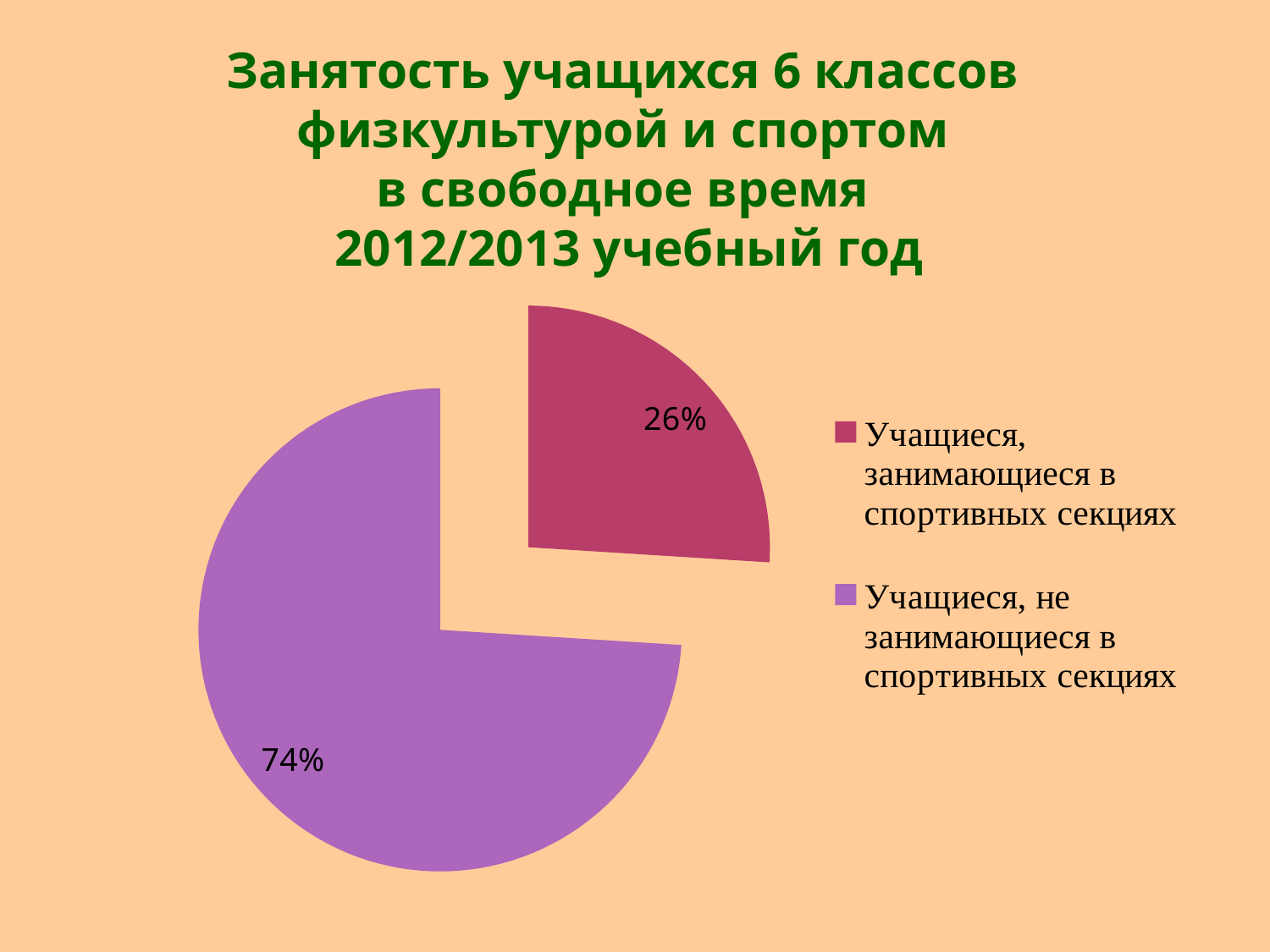
What kind of chart is shown on the slide? pie chart Which category has the smallest slice of the pie? Учащиеся, занимающиеся в спортивных секциях What is the difference in percentage points between the two slices of the pie? 48 Which is larger: the share of students attending sports sections or the share not attending? Учащиеся, не занимающиеся в спортивных секциях What share of the pie is labelled "Учащиеся, не занимающиеся в спортивных секциях"? 74% How many entries does the legend list? 2 Which category has the largest slice of the pie? Учащиеся, не занимающиеся в спортивных секциях Which academic year is named in the chart title? 2012/2013 учебный год What share of the pie is labelled "Учащиеся, занимающиеся в спортивных секциях"? 26% How many slices does the pie chart have? 2 What colour is the slice for "Учащиеся, занимающиеся в спортивных секциях"? dark pink (crimson)